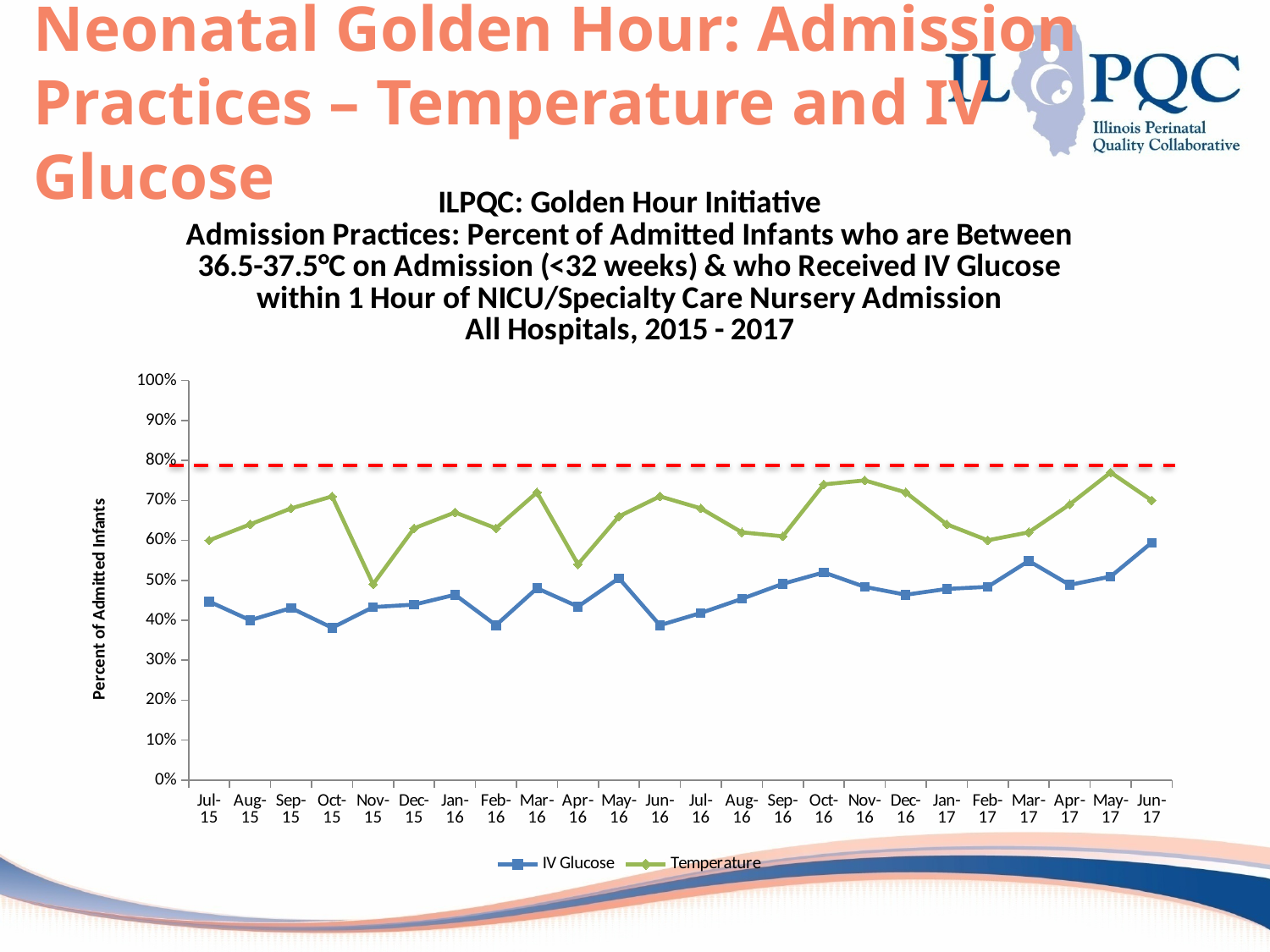
Is the IV Glucose value for Oct-15 greater or less than 40%? less What are the two series named in the chart legend? IV Glucose and Temperature In Nov-15, which series has the higher value, IV Glucose or Temperature? Temperature How many monthly data points are plotted along the x axis for each series? 24 In which month is the Temperature series at its lowest value? Nov-15 What kind of chart is shown on the slide? Line chart In which month is the IV Glucose series at its highest value? Jun-17 What is the label on the vertical axis of the chart? Percent of Admitted Infants Is the IV Glucose value for Jun-17 greater or less than 50%? greater Does the IV Glucose series overall rise or fall from Jul-15 to Jun-17? Rise How many series does the chart legend list? 2 Is the Temperature value for Nov-16 greater or less than 70%? greater